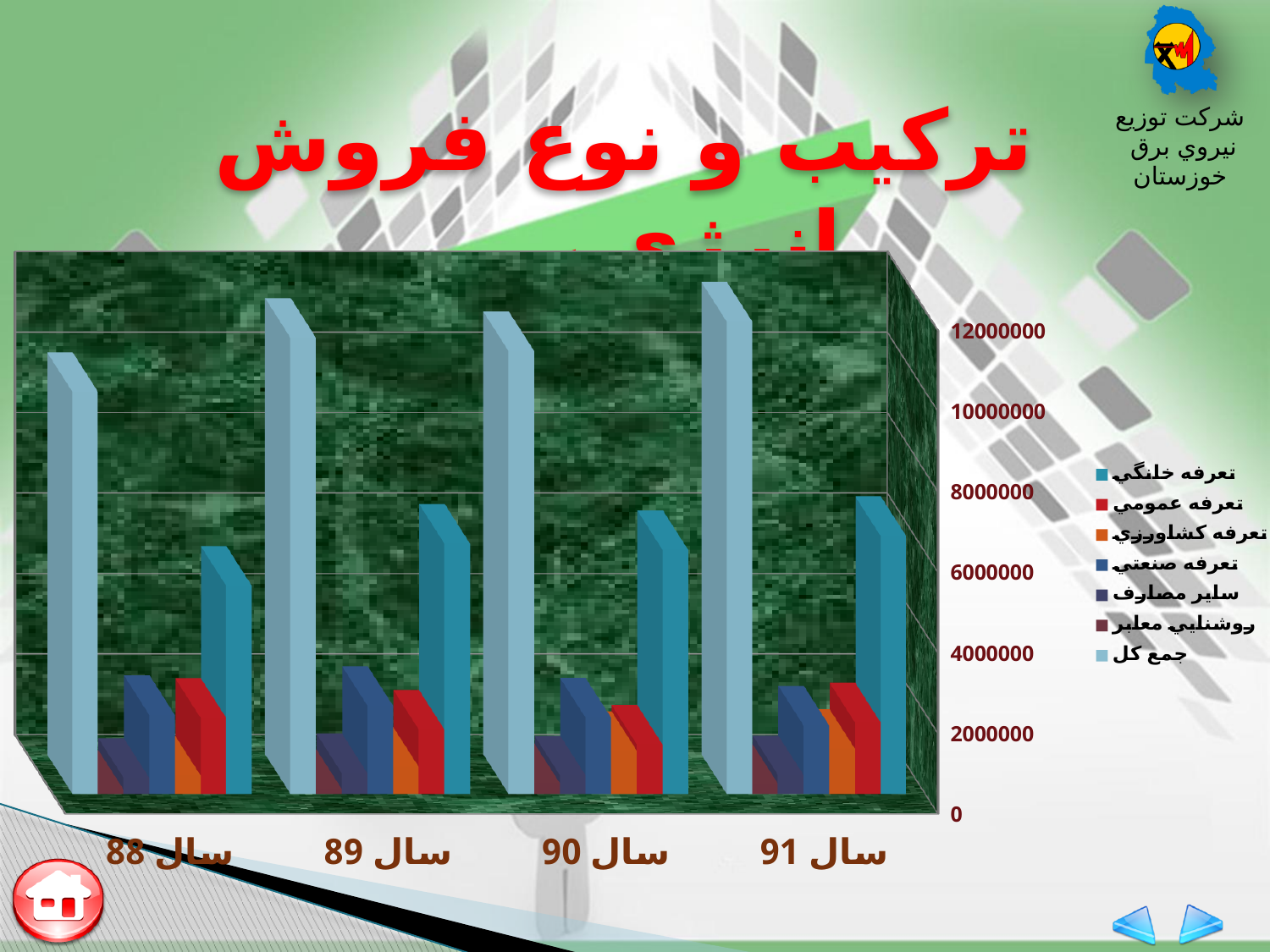
Which year has the lowest value for جمع كل? سال 88 Is the value of جمع كل for سال 88 greater or less than 8000000? greater Is the value of تعرفه خانگي for سال 88 greater or less than 8000000? less In سال 88, which is larger, تعرفه خانگي or تعرفه صنعتي? تعرفه خانگي Which is larger, the جمع كل value for سال 91 or for سال 88? سال 91 What kind of chart is shown on the slide? bar chart Which year has the highest value for جمع كل? سال 91 How many series does the chart legend list? 7 What colour represents جمع كل in the chart legend? light blue How many year categories are shown on the x axis of the chart? 4 What is the highest tick value shown on the value axis of the chart? 12000000 Is the value of تعرفه صنعتي for سال 89 greater or less than 6000000? less